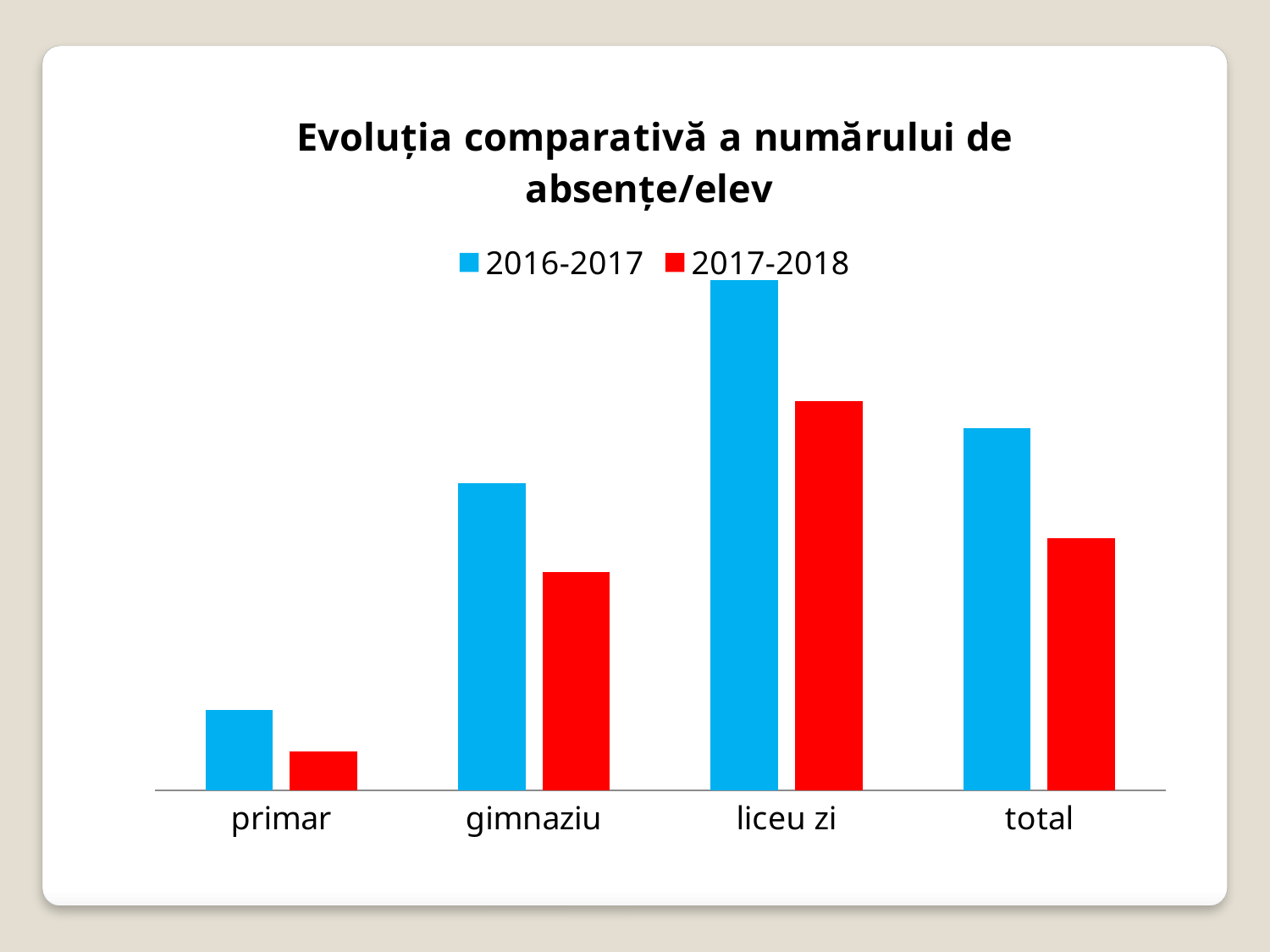
For the category total, which series has the larger value, 2016-2017 or 2017-2018? 2016-2017 How many series does the legend list? 2 What kind of chart is shown on the slide? bar chart Which is larger: the 2017-2018 value for gimnaziu or the 2017-2018 value for total? total Which category has the highest value for the 2017-2018 series? liceu zi Which category has the lowest value for the 2016-2017 series? primar How many categories are shown on the x axis? 4 Which category has the highest value for the 2016-2017 series? liceu zi What is the title of the chart? Evoluția comparativă a numărului de absențe/elev Which colour represents the 2017-2018 series in the legend? red For the category liceu zi, which series has the larger value, 2016-2017 or 2017-2018? 2016-2017 Which category has the lowest value for the 2017-2018 series? primar